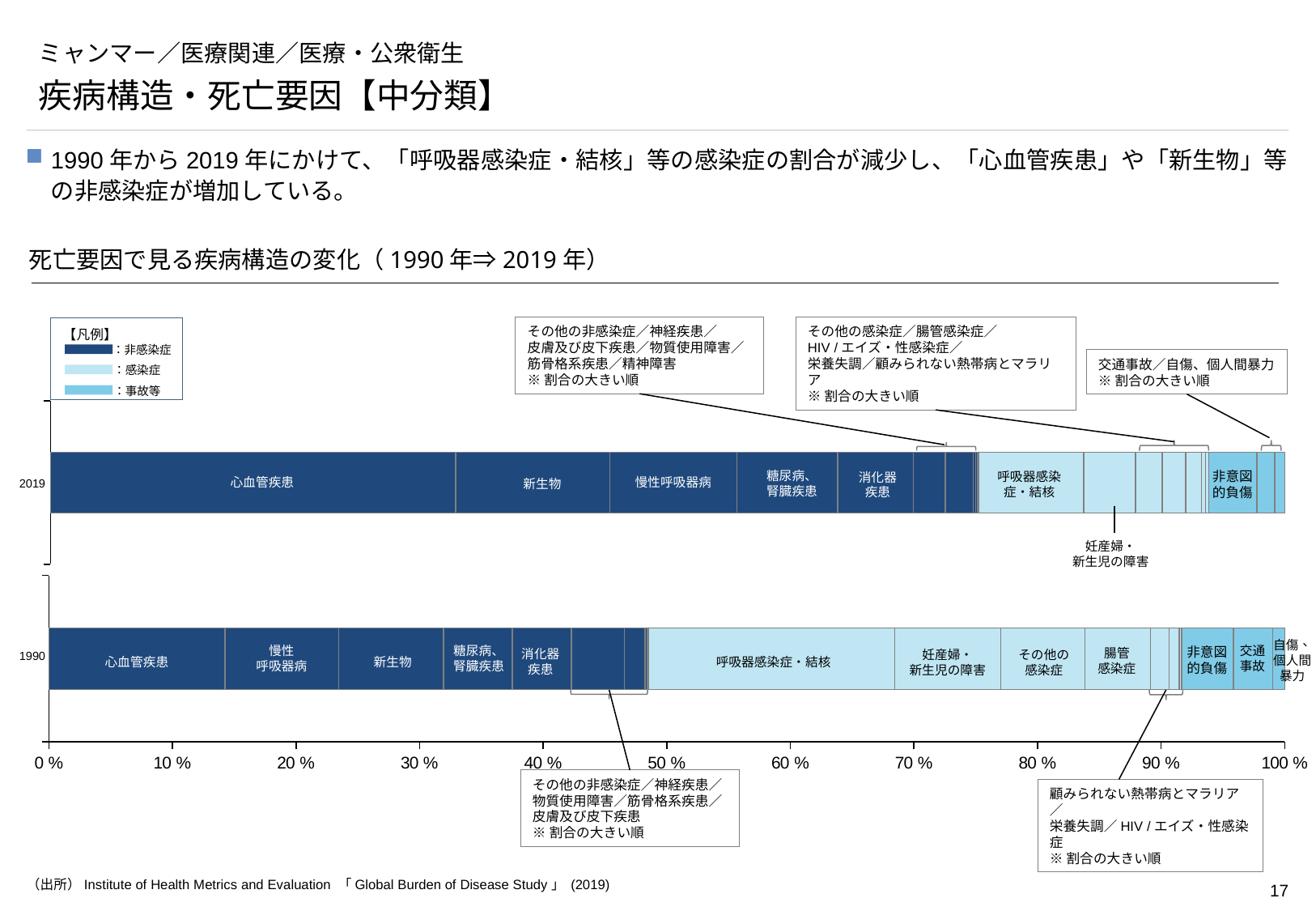
Which year is shown in the top bar of the chart? 2019 In the 2019 bar, which cause of death has the largest share? 心血管疾患 Is the share of 心血管疾患 in 2019 greater or less than 30%? greater Is the share of 心血管疾患 in 1990 greater or less than 20%? less What kind of chart is shown on the slide? Stacked bar chart How many categories does the legend (凡例) list? 3 Which year has the larger share of 新生物, 1990 or 2019? 2019 Which category does the dark blue colour represent in the legend? 非感染症 In the 1990 bar, which cause of death has the largest share? 呼吸器感染症・結核 Is the share of 呼吸器感染症・結核 in 2019 greater or less than 10%? less Which year has the larger share of 呼吸器感染症・結核, 1990 or 2019? 1990 How many bars (years) does the chart show? 2